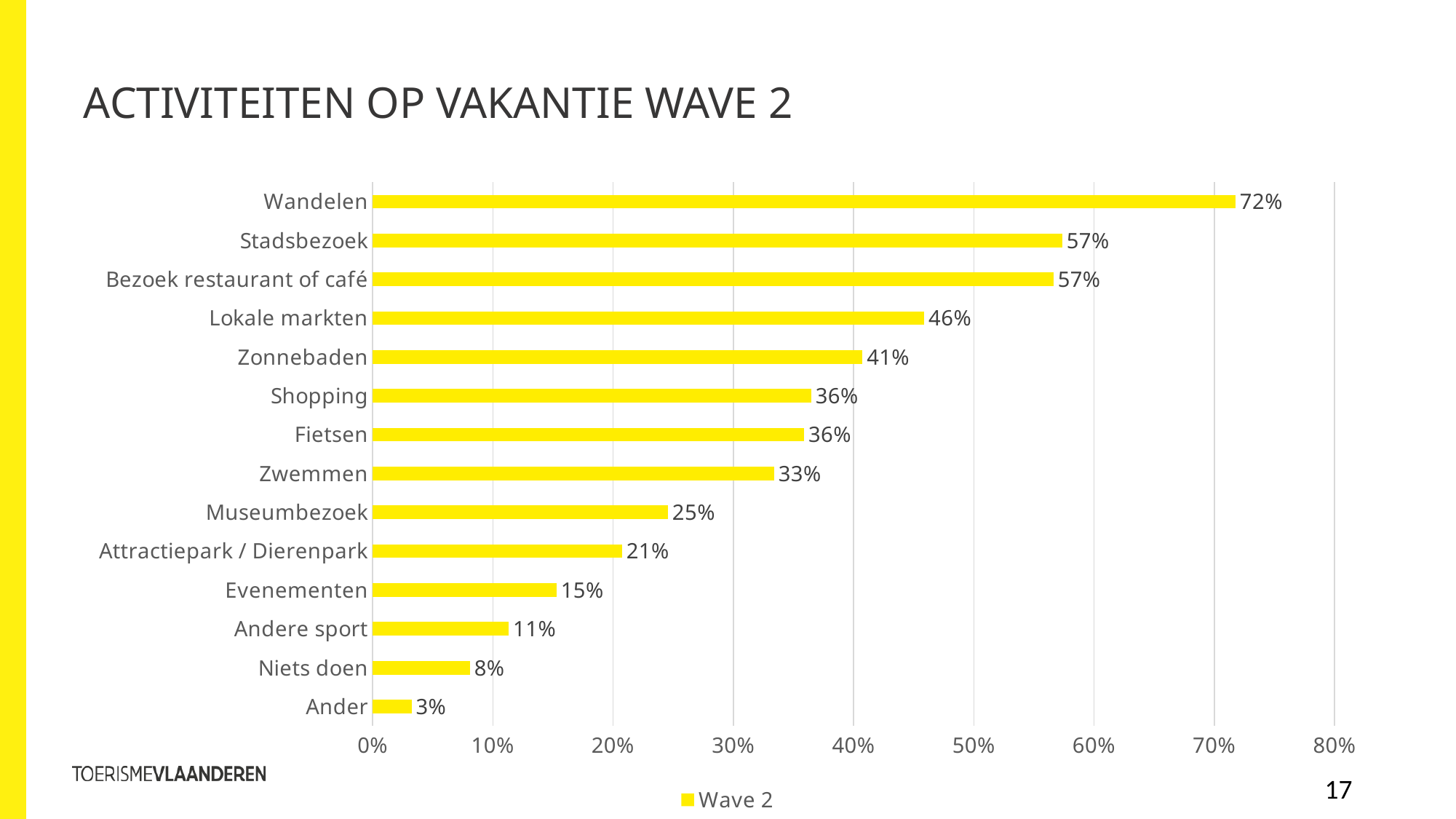
What is the value for Wandelen? 72% Which activity has the highest value? Wandelen What kind of chart is shown on the slide? Bar chart What is the value for Zonnebaden? 41% Which is larger, the value for Evenementen or the value for Andere sport? Evenementen Is the value for Lokale markten greater or less than 40%? greater What is the difference between the values for Lokale markten and Zwemmen? 13% What is the value for Museumbezoek? 25% What series does the legend list? Wave 2 What is the difference between the values for Wandelen and Stadsbezoek? 15% How many activities are shown in the chart? 14 Which activity has the lowest value? Ander